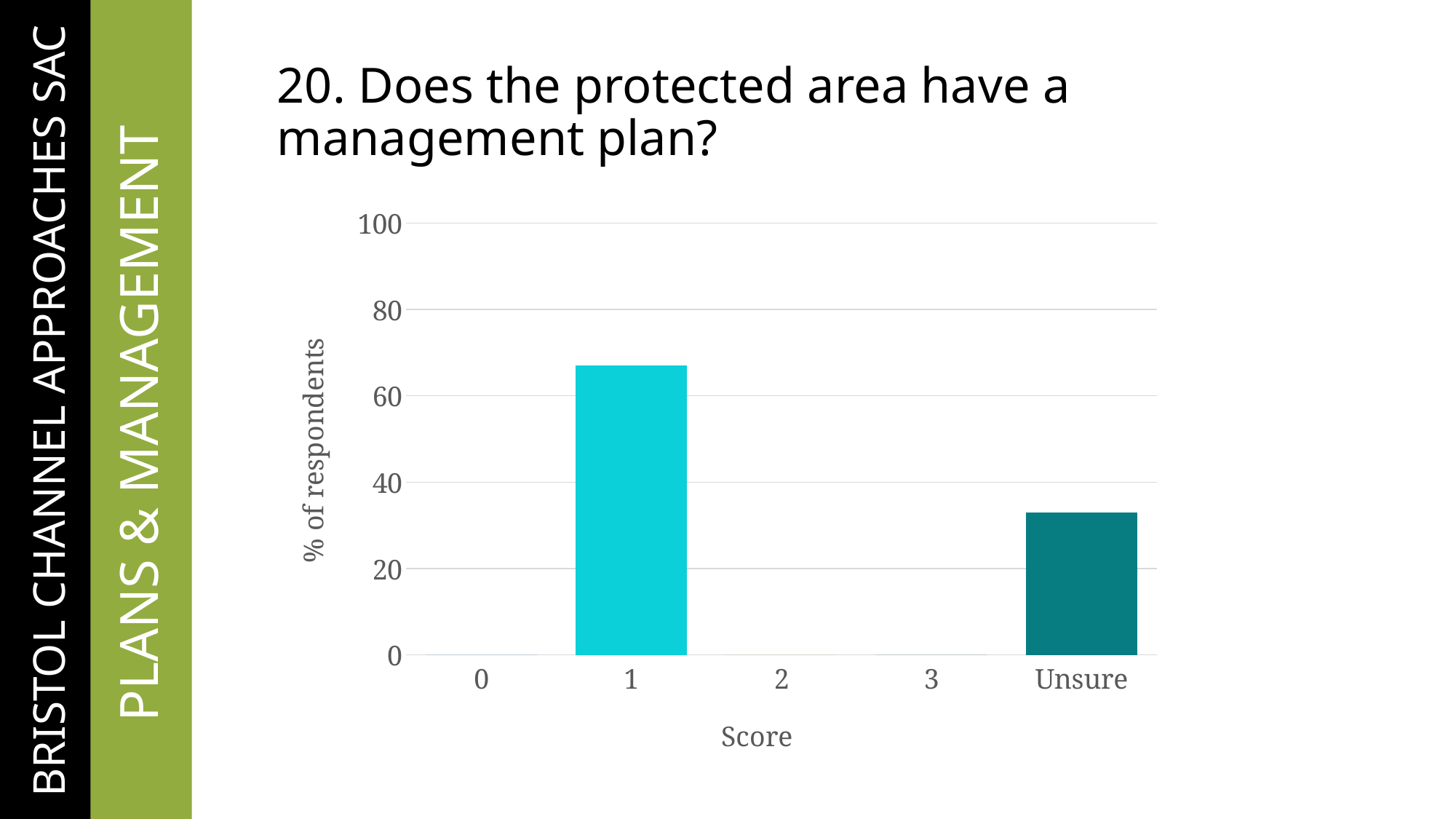
Is the value for score 1 greater or less than 60? greater Which score category has the highest percentage of respondents? 1 Which has a larger percentage of respondents, score 1 or Unsure? 1 Is the value for Unsure greater or less than 40? less What kind of chart is shown on the slide? bar chart Is the value for score 1 greater or less than 80? less What is the label of the y axis? % of respondents What is the label of the x axis? Score How many score categories are shown on the x axis? 5